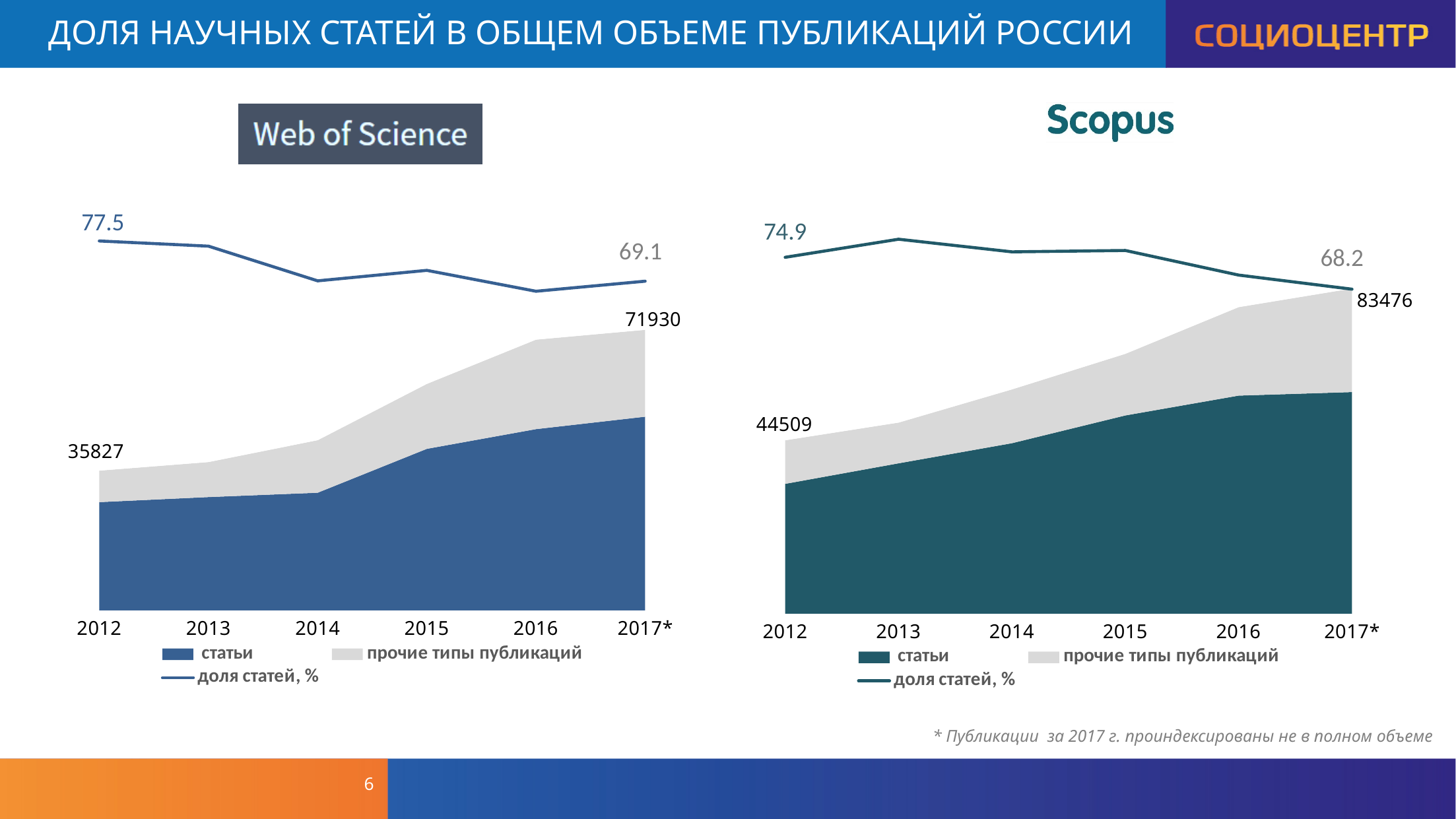
In the Scopus chart, how many years are shown on the x axis? 6 In the Scopus chart, by how many percentage points did the share of articles fall from 2012 to 2017*? 6.7 What kind of chart is the Scopus chart? stacked area chart with a line In the Web of Science chart, what is the share of articles (доля статей, %) in 2012? 77.5 In the Web of Science chart, what is the share of articles (доля статей, %) in 2017*? 69.1 In the Scopus chart, what is the share of articles (доля статей, %) in 2017*? 68.2 In the Web of Science chart, does the share of articles (доля статей, %) line rise or fall from 2012 to 2017*? fall In the Web of Science chart, by how much did the labelled total number of publications grow from 2012 to 2017*? 36103 In the Scopus chart, what is the total number of publications labelled for 2012? 44509 Which chart shows the larger labelled total of publications in 2017*, Web of Science or Scopus? Scopus In the Web of Science chart, what is the total number of publications labelled for 2017*? 71930 In the Web of Science chart, how many series does the legend list? 3